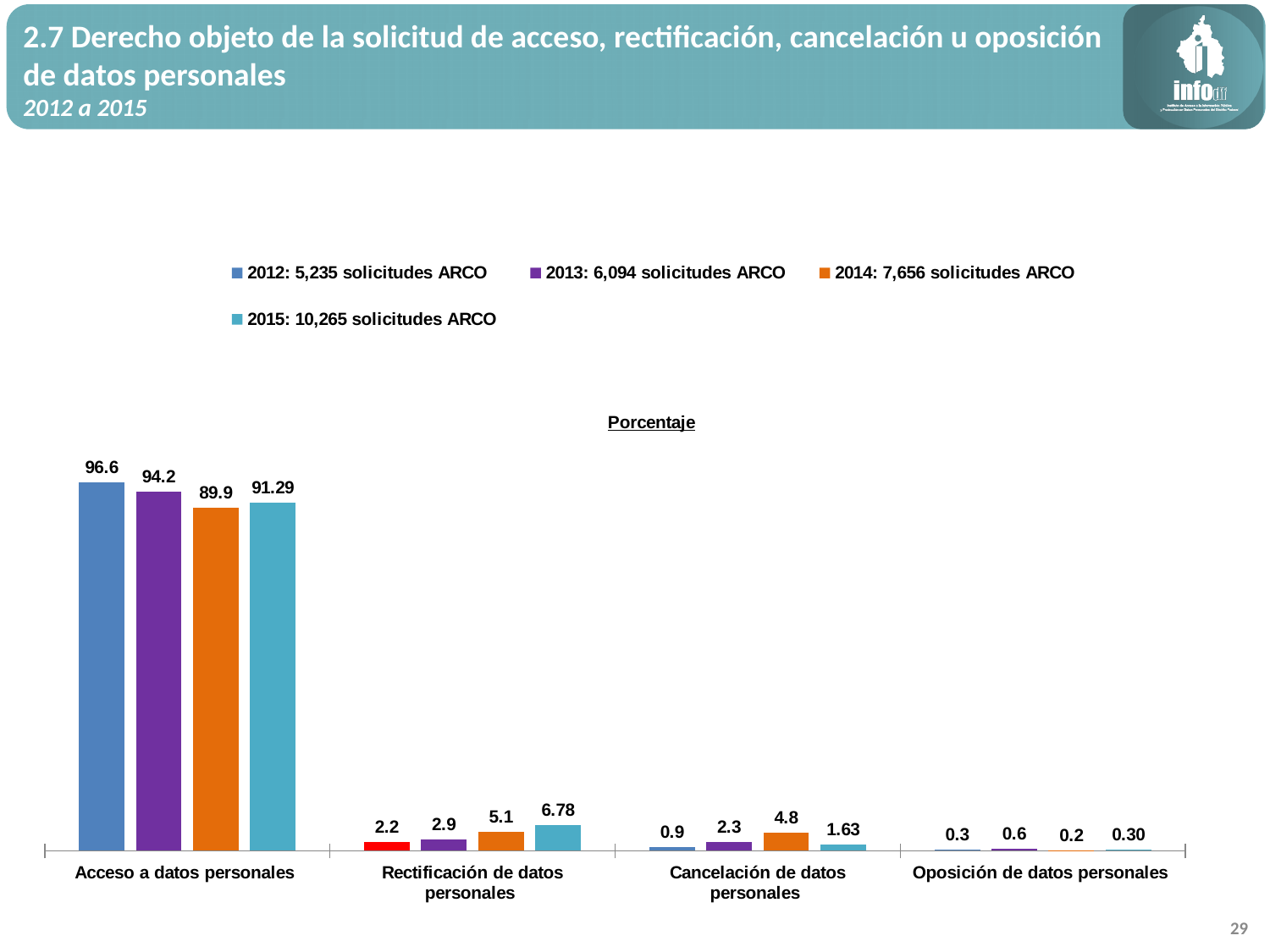
Which year has the highest value for 'Acceso a datos personales'? 2012 Which year has the lowest value for 'Rectificación de datos personales'? 2012 What is the value for 'Acceso a datos personales' in the 2012 series? 96.6 Which is larger: the 2014 value for 'Cancelación de datos personales' or the 2015 value for 'Cancelación de datos personales'? 2014 What is the value for 'Rectificación de datos personales' in the 2015 series? 6.78 What is the value for 'Cancelación de datos personales' in the 2014 series? 4.8 How many categories are shown on the x axis? 4 What kind of chart is shown on the slide? Bar chart What is the value for 'Oposición de datos personales' in the 2013 series? 0.6 How many series does the legend list? 4 According to the legend, how many solicitudes ARCO were there in 2015? 10,265 What is the difference between the 2012 and 2014 values for 'Acceso a datos personales'? 6.7